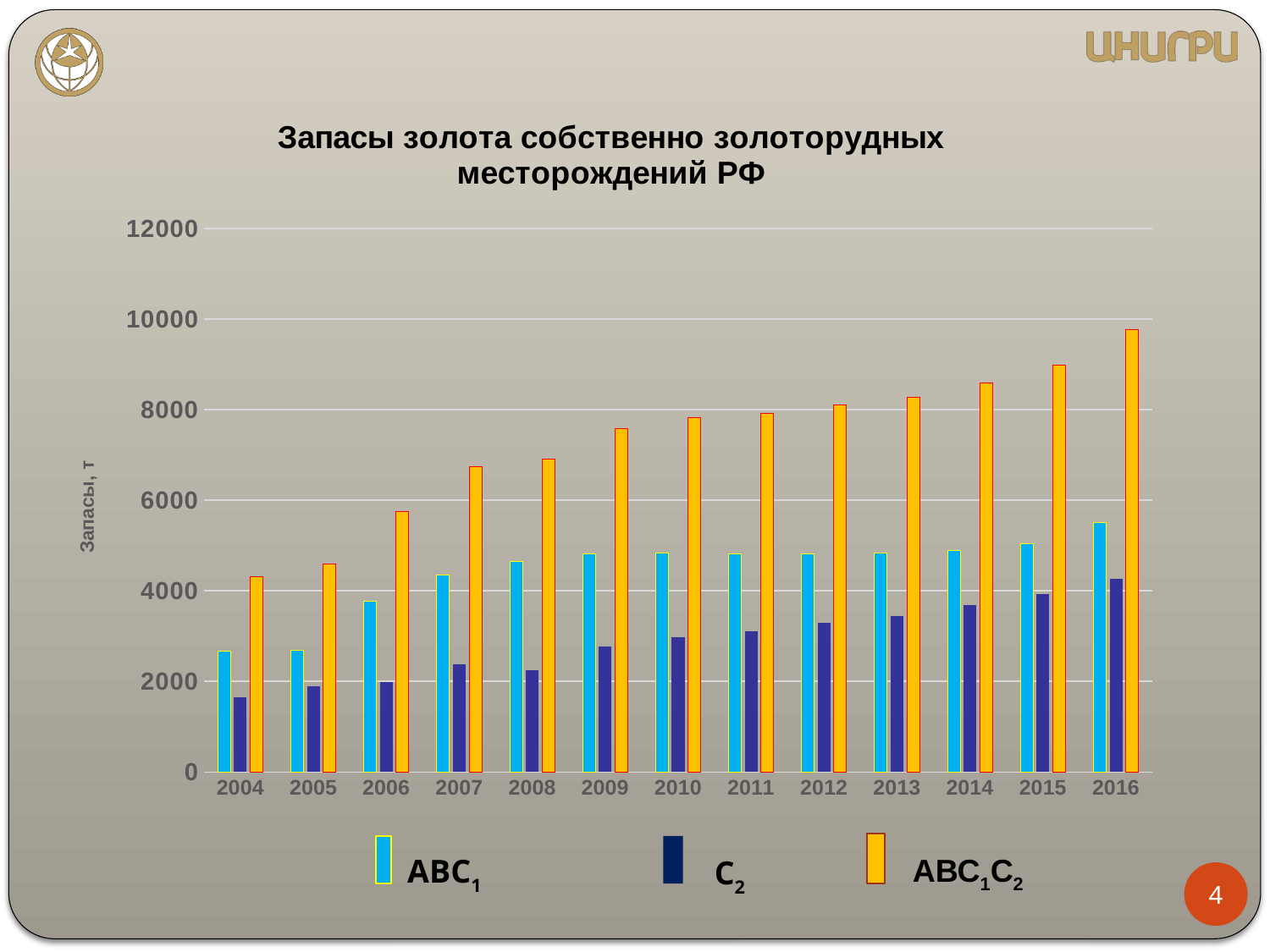
How many series does the legend list? 3 What kind of chart is shown on the slide? bar chart Is the C2 value for 2004 greater or less than 2000? less What is the title of the chart? Запасы золота собственно золоторудных месторождений РФ How many years are shown on the x axis of the chart? 13 In which year is the ABC1C2 value highest? 2016 Is the ABC1C2 value for 2016 greater or less than 8000? greater Do the ABC1C2 values rise or fall from 2004 to 2016? rise Is the ABC1C2 value for 2009 greater or less than 8000? less Which is larger in 2016, the ABC1 value or the C2 value? ABC1 In which year is the C2 value lowest? 2004